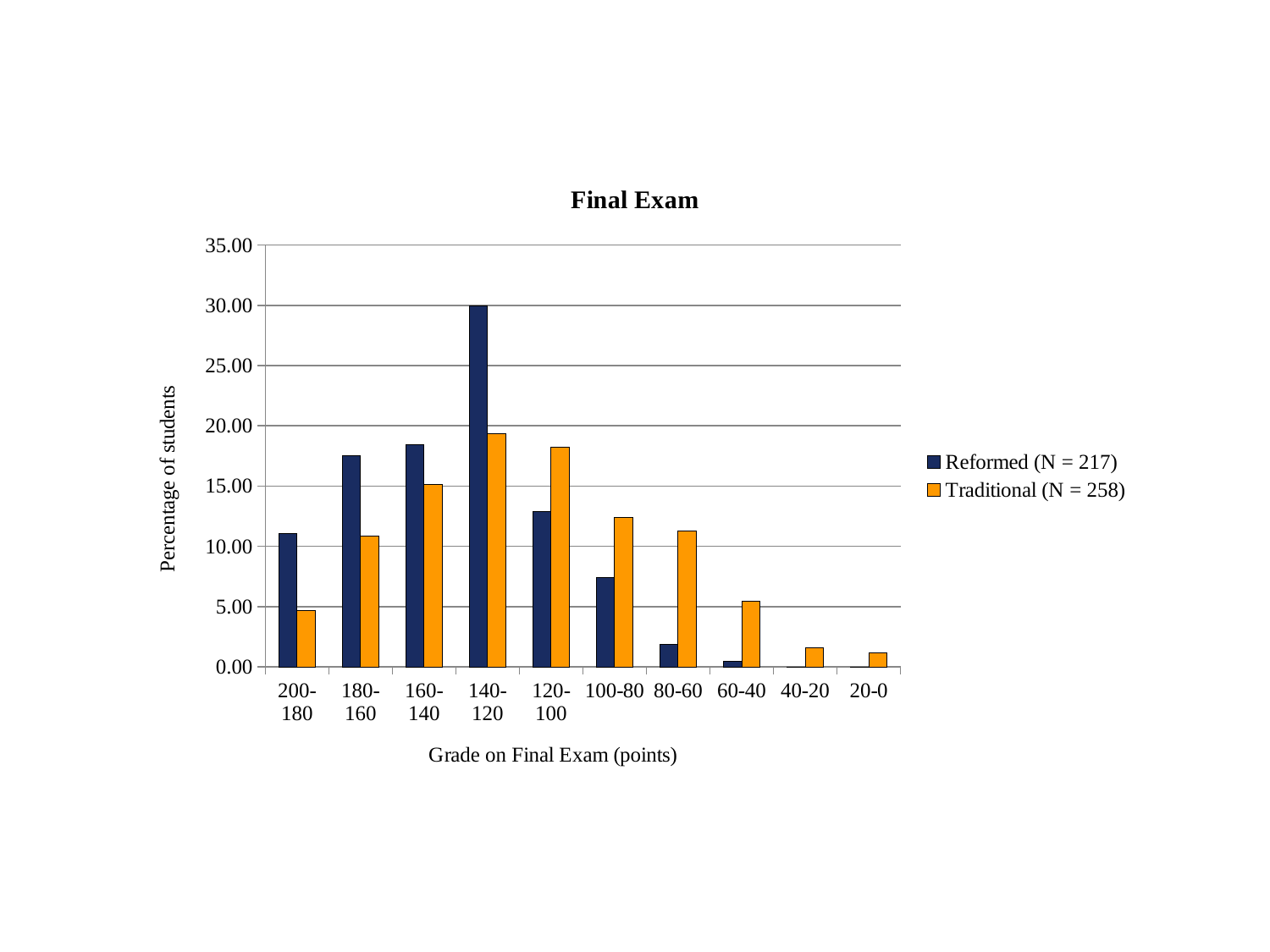
How many grade ranges are shown on the x axis? 10 Is the Reformed (N = 217) value for the 180-160 grade range greater or less than 15.00? greater What kind of chart is shown on the slide? bar chart What is the label on the y axis of the chart? Percentage of students Which grade range has the highest percentage of students for the Reformed (N = 217) series? 140-120 For the 200-180 grade range, which series has the larger percentage of students, Reformed (N = 217) or Traditional (N = 258)? Reformed (N = 217) For the 80-60 grade range, which series has the larger percentage of students, Reformed (N = 217) or Traditional (N = 258)? Traditional (N = 258) What is the title of the chart? Final Exam How many series does the legend list? 2 Is the Traditional (N = 258) value for the 80-60 grade range greater or less than 10.00? greater Is the Reformed (N = 217) value for the 140-120 grade range greater or less than 25.00? greater